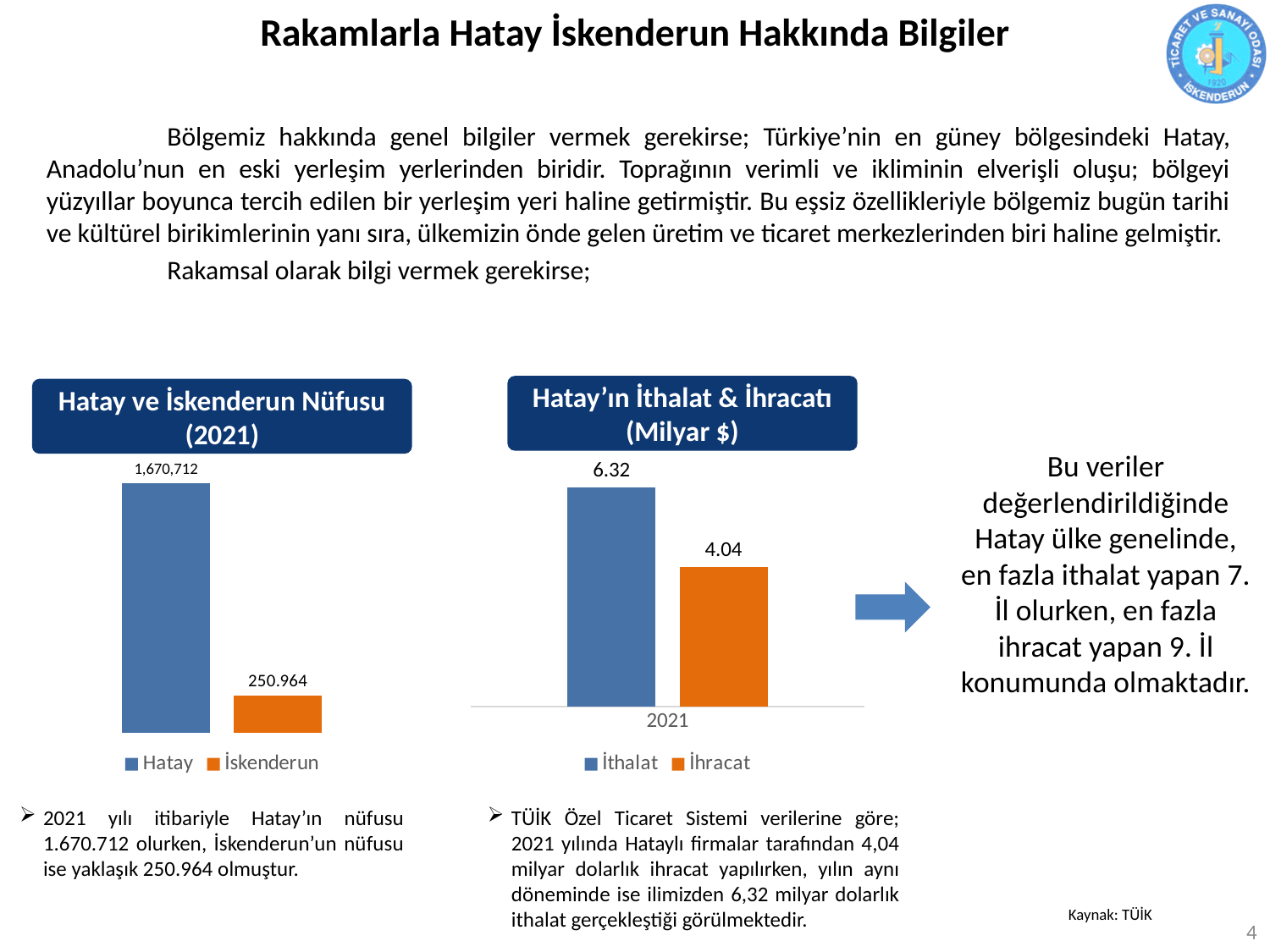
What kind of chart is the one titled "Hatay ve İskenderun Nüfusu (2021)"? Bar chart In the chart titled "Hatay'ın İthalat & İhracatı (Milyar $)", which year is shown on the x axis? 2021 In the chart titled "Hatay'ın İthalat & İhracatı (Milyar $)", what colour is the İhracat bar? Orange In the chart titled "Hatay ve İskenderun Nüfusu (2021)", how many series does the legend list? 2 In the chart titled "Hatay'ın İthalat & İhracatı (Milyar $)", what is the value for İhracat? 4.04 In the chart titled "Hatay ve İskenderun Nüfusu (2021)", which series has the larger value? Hatay In the chart titled "Hatay'ın İthalat & İhracatı (Milyar $)", which is larger, İthalat or İhracat? İthalat In the chart titled "Hatay ve İskenderun Nüfusu (2021)", what is the value shown for Hatay? 1,670,712 In the chart titled "Hatay ve İskenderun Nüfusu (2021)", what is the value shown for İskenderun? 250.964 In the chart titled "Hatay'ın İthalat & İhracatı (Milyar $)", what is the difference between İthalat and İhracat? 2.28 In the chart titled "Hatay'ın İthalat & İhracatı (Milyar $)", what is the value for İthalat? 6.32 How many charts are shown on the slide? 2